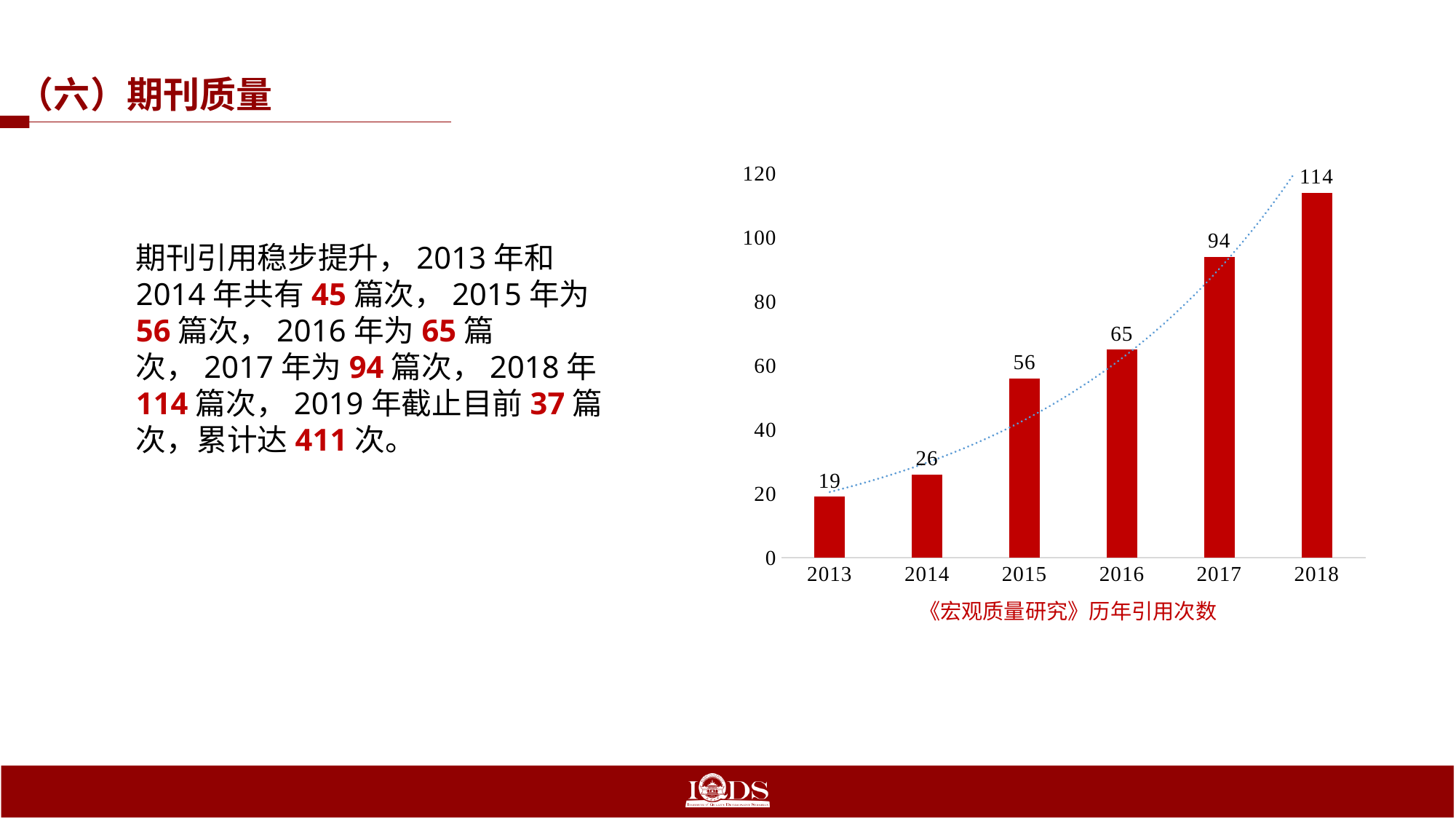
What is the difference between the values for 2016 and 2015? 9 What is the difference between the values for 2018 and 2017? 20 What kind of chart is shown on the slide? bar chart What is the value for 2018? 114 What is the value for 2013? 19 What is the value for 2015? 56 Is the value for 2017 greater or less than 80? greater Which year has the lowest value? 2013 Do the values rise or fall from 2013 to 2018? rise Which year has the highest value? 2018 How many years are shown on the x axis? 6 Which is larger, the value for 2014 or the value for 2016? 2016